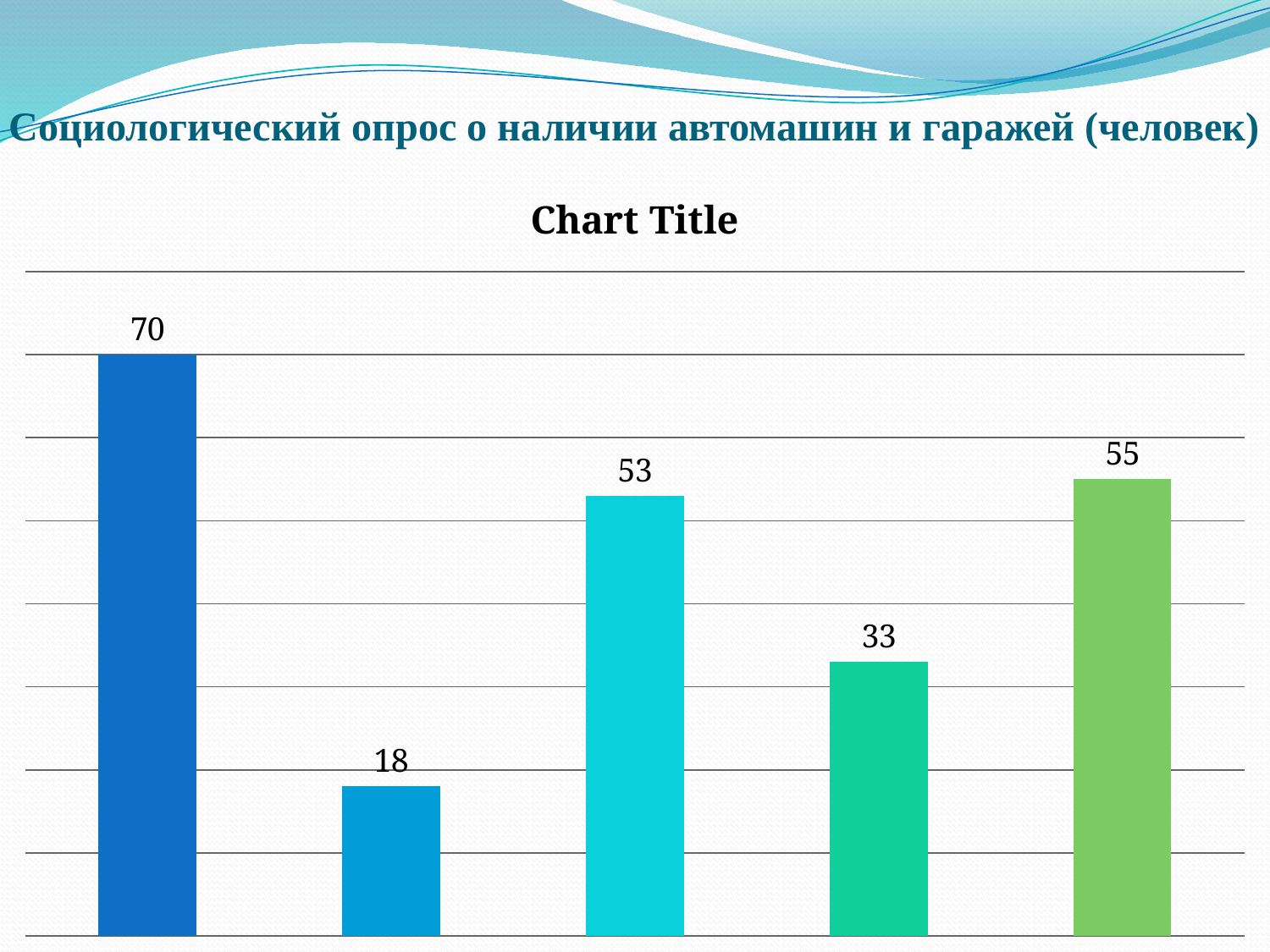
What is the value of the first (leftmost) bar? 70 What is the title printed above the chart? Chart Title What type of chart is shown on the slide? bar chart How many bars does the chart contain? 5 What is the difference between the first bar (70) and the second bar (18)? 52 Which bar has the highest value? the first (leftmost) bar, 70 What is the value of the second bar from the left? 18 What is the value of the middle (third) bar? 53 What is the value of the fourth bar from the left? 33 Which is larger, the third bar or the fifth bar? the fifth bar (55) What is the value of the last (rightmost) bar? 55 Which bar has the lowest value? the second bar, 18